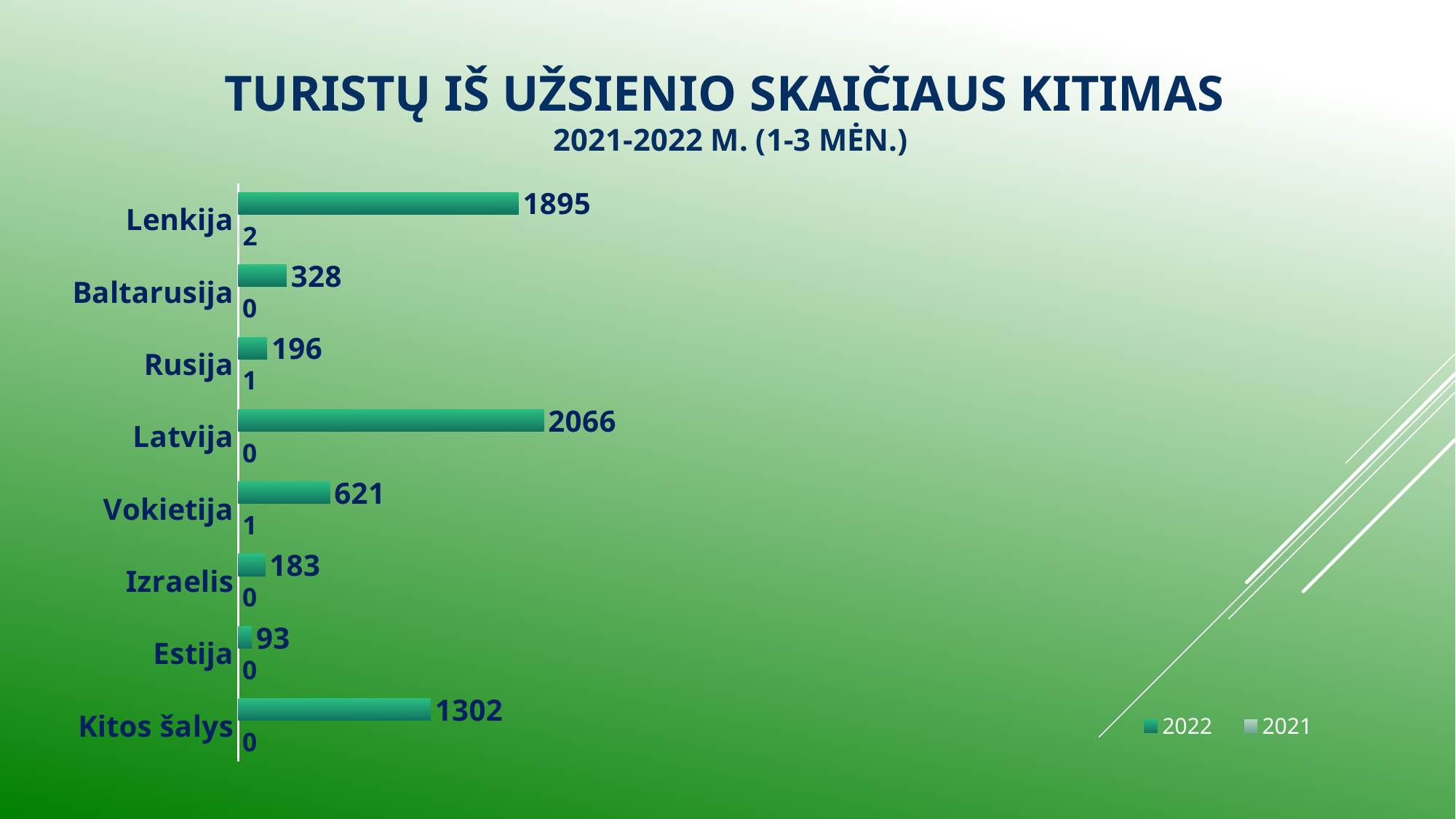
Which has a larger 2022 value, Vokietija or Baltarusija? Vokietija Which category has the highest 2022 value? Latvija What is the 2022 value for Latvija? 2066 What is the difference between the 2022 values for Latvija and Lenkija? 171 How many series does the legend list? 2 What is the title of the chart? TURISTŲ IŠ UŽSIENIO SKAIČIAUS KITIMAS 2021-2022 M. (1-3 MĖN.) What is the 2021 value for Lenkija? 2 What is the 2022 value for Baltarusija? 328 How many categories are shown on the chart? 8 What is the 2022 value for Kitos šalys? 1302 What kind of chart is shown on the slide? Bar chart Which category has the lowest 2022 value? Estija